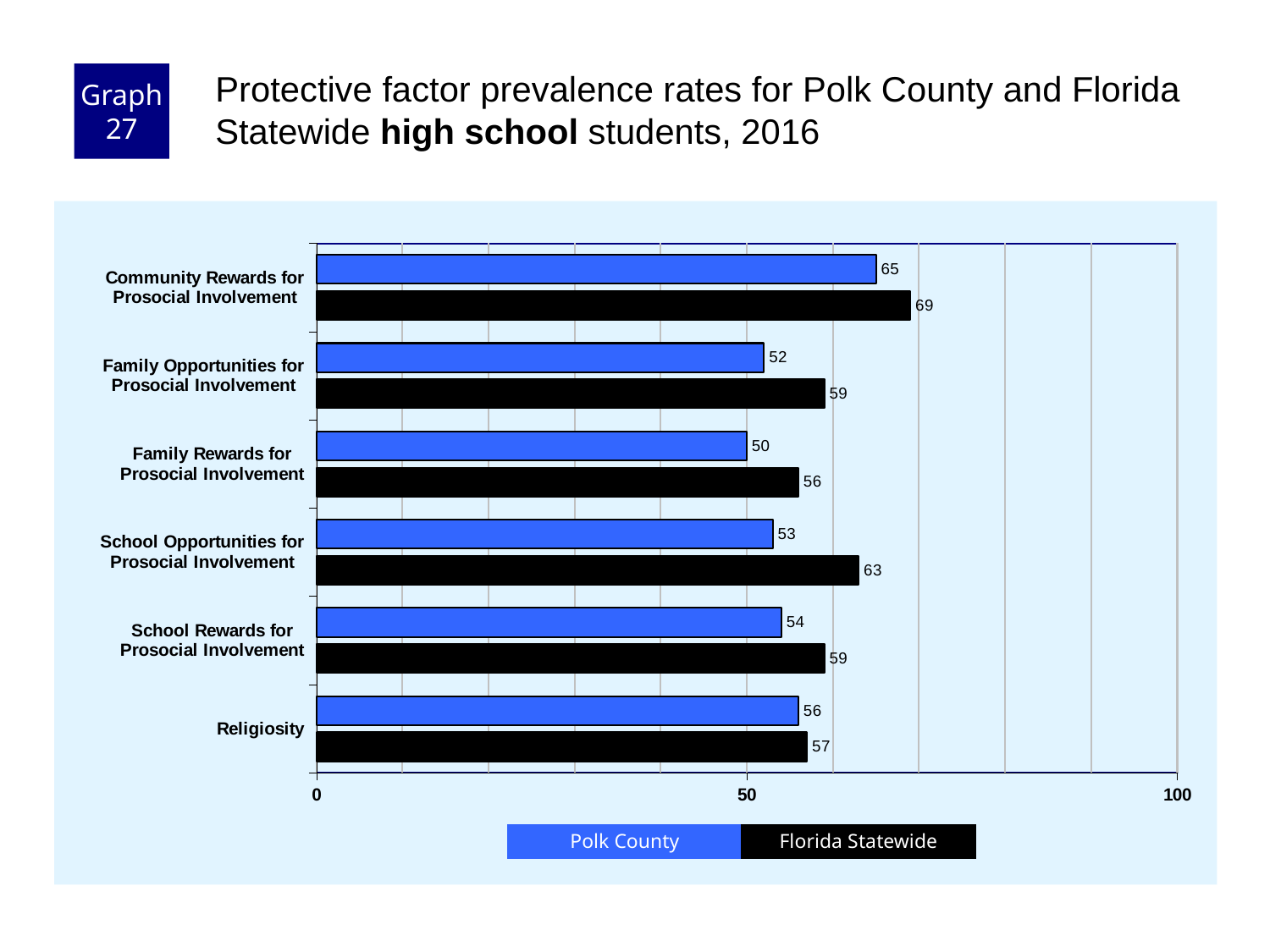
Which protective factor has the lowest Polk County value? Family Rewards for Prosocial Involvement How many protective factors are shown on the chart? 6 What is the Polk County value for Religiosity? 56 What is the Florida Statewide value for School Opportunities for Prosocial Involvement? 63 What is the difference between the Florida Statewide and Polk County values for School Opportunities for Prosocial Involvement? 10 Which colour represents Florida Statewide in the chart? Black Which is larger for Family Opportunities for Prosocial Involvement: the Polk County value or the Florida Statewide value? Florida Statewide What is the Polk County value for Community Rewards for Prosocial Involvement? 65 What kind of chart is shown on the slide? Bar chart Is the Florida Statewide value for Community Rewards for Prosocial Involvement greater or less than 50? greater How many series does the legend list? 2 Which protective factor has the highest Florida Statewide value? Community Rewards for Prosocial Involvement